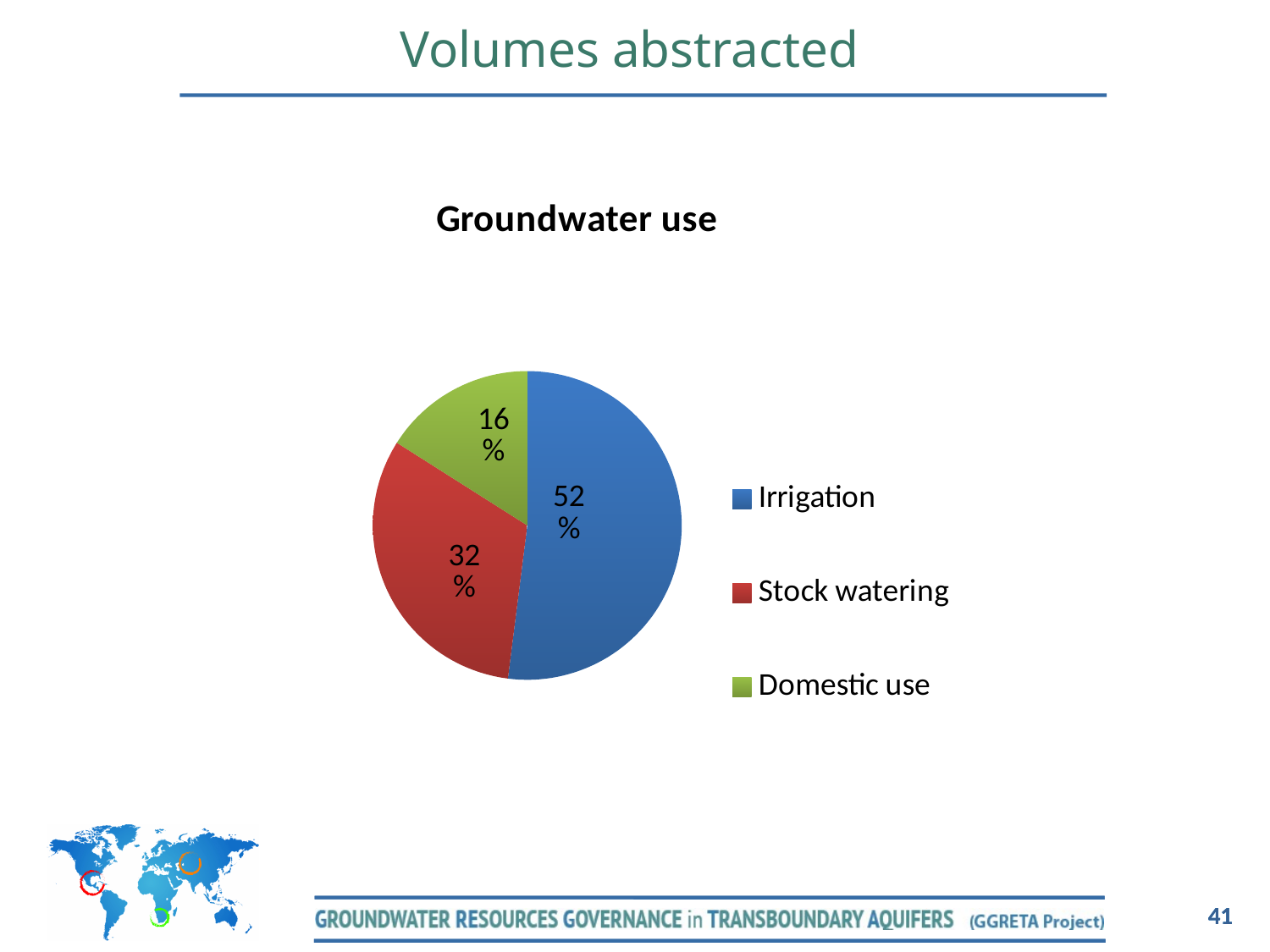
Which is larger, the share for Stock watering or the share for Domestic use? Stock watering How many categories does the pie chart show? 3 What is the title of the chart? Groundwater use What colour is the Irrigation slice in the pie chart? blue What share of groundwater use is Domestic use? 16% What share of groundwater use is Irrigation? 52% What is the difference between the Irrigation share and the Stock watering share? 20% Which category has the smallest share of groundwater use? Domestic use Which category has the largest share of groundwater use? Irrigation What share of groundwater use is Stock watering? 32% What type of chart is shown on the slide? pie chart What is the difference between the Stock watering share and the Domestic use share? 16%